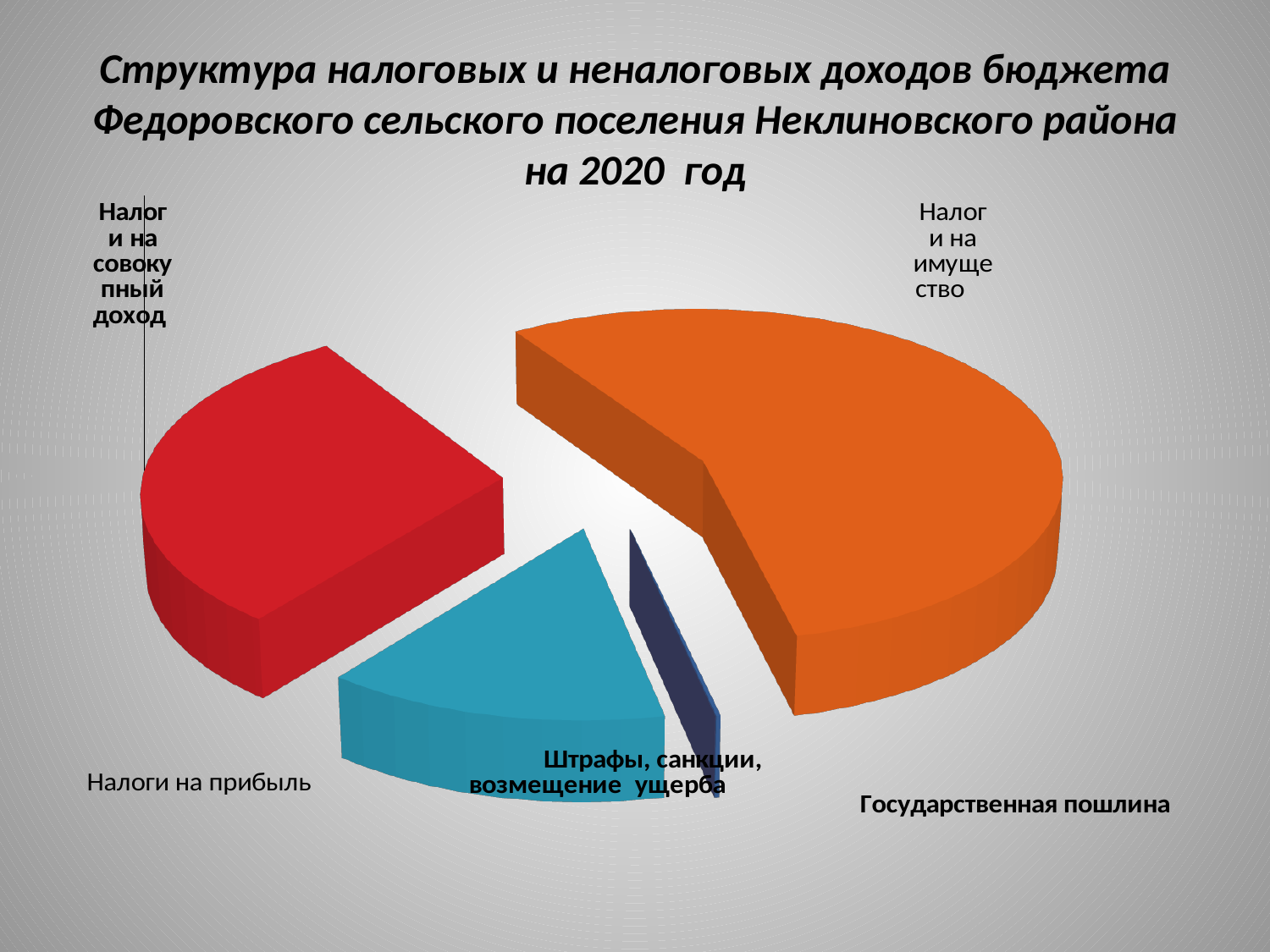
Which slice is larger, Налог на имущество or Налоги на прибыль? Налог на имущество How many categories are labelled on the pie chart? 5 What kind of chart is shown on the slide? pie chart Which year does the chart title say the budget revenue structure refers to? 2020 What colour is the slice for Налог на имущество? orange Which category has the largest slice of the pie chart? Налог на имущество Which slice is larger, Налог на имущество or Штрафы, санкции, возмещение ущерба? Налог на имущество